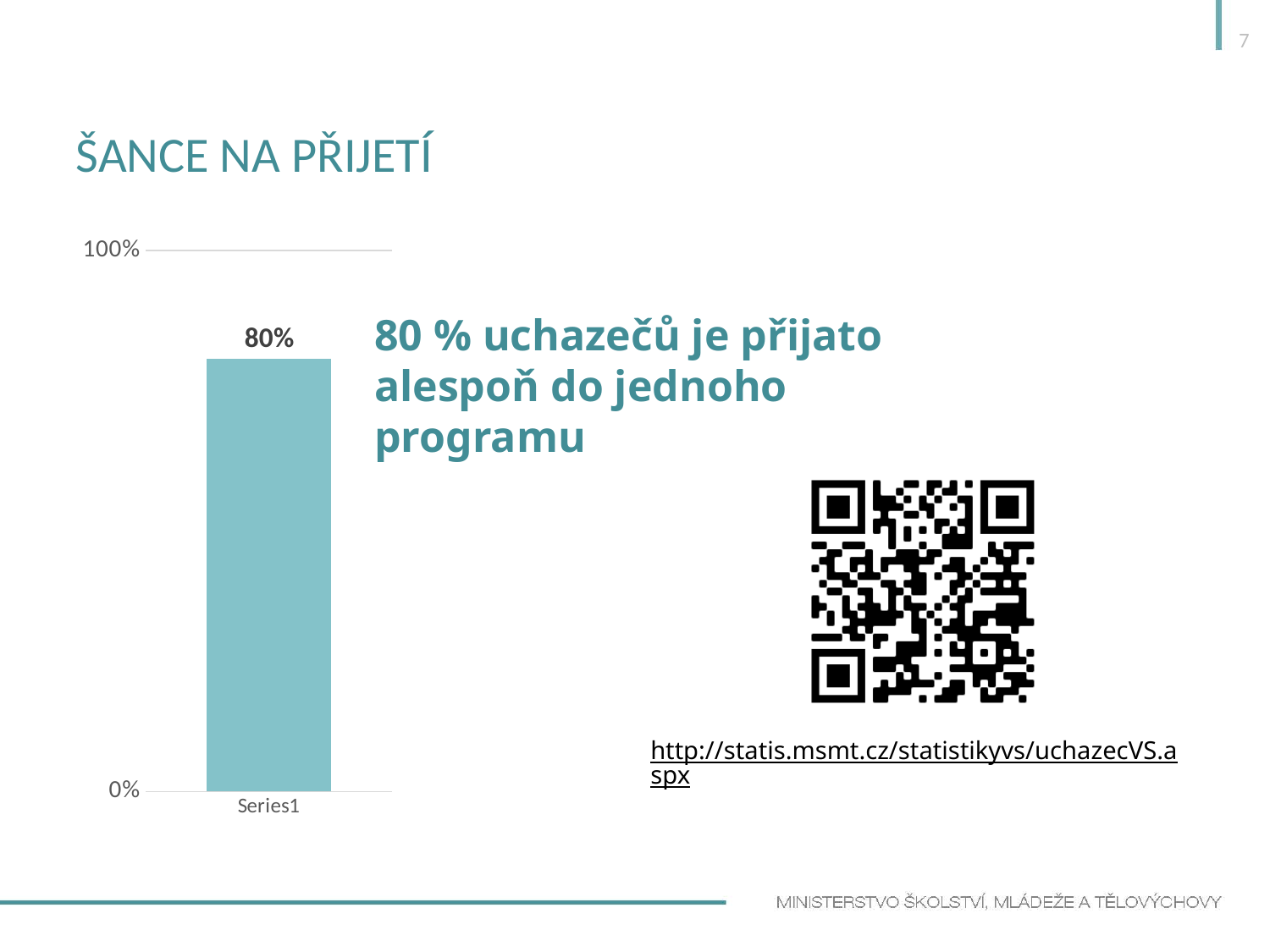
How many bars does the chart contain? 1 Is the value for Series1 greater or less than 100%? less What is the value shown for Series1 in the bar chart? 80% What is the label of the category on the x axis of the chart? Series1 What kind of chart is shown on the slide? bar chart What is the highest value shown on the vertical axis of the chart? 100%